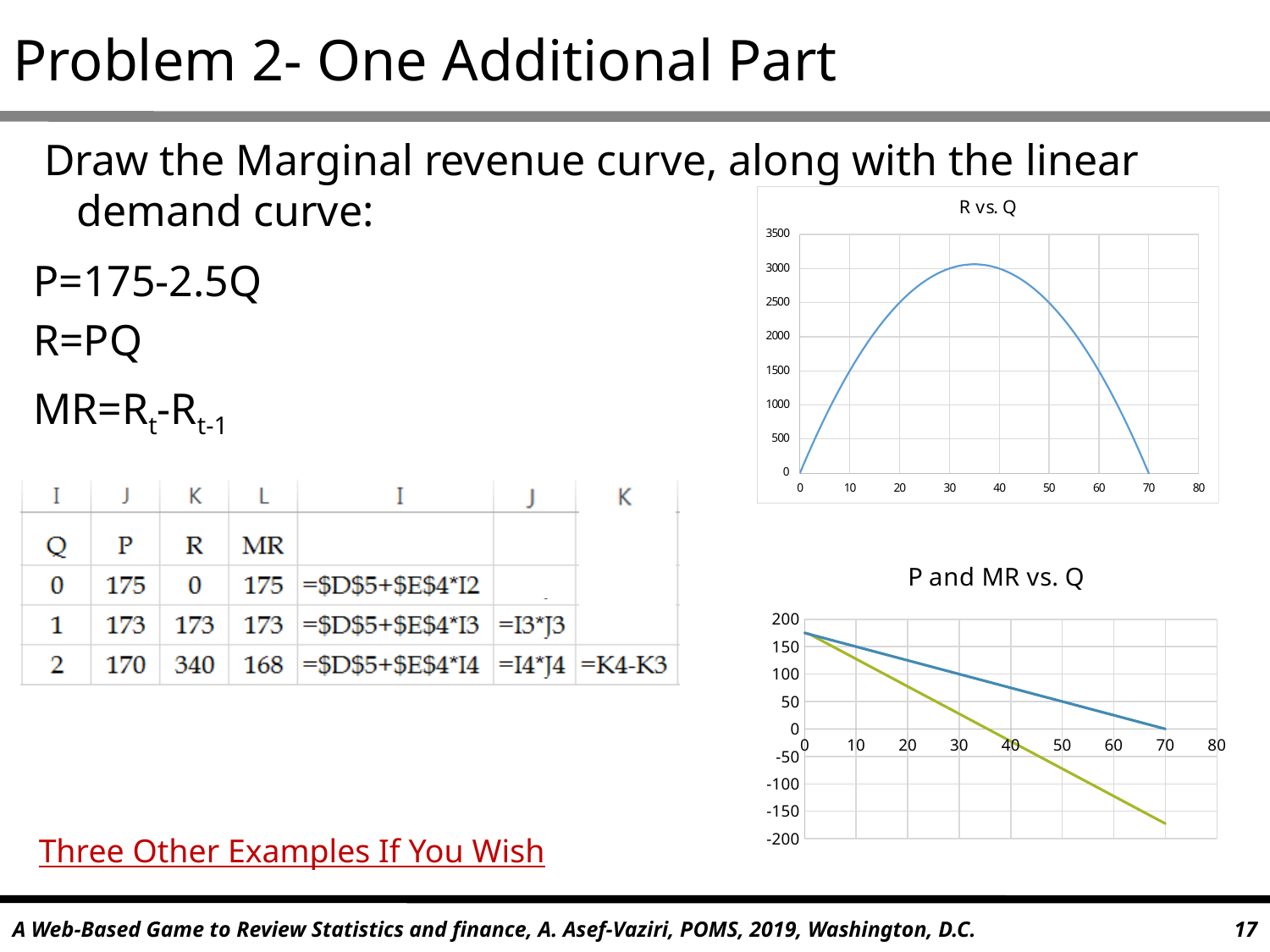
What kind of chart is the 'R vs. Q' chart? line chart In the 'P and MR vs. Q' chart, do the lines rise or fall as Q increases? fall In the 'R vs. Q' chart, does the curve rise or fall as Q goes from 40 to 70? fall In the 'R vs. Q' chart, is the peak value of the curve greater or less than 3500? less In the 'R vs. Q' chart, does the curve rise or fall as Q goes from 0 to 30? rise In the 'P and MR vs. Q' chart, is the value of the blue line at Q=40 greater or less than 50? greater In the 'P and MR vs. Q' chart, is the value of the green line at Q=70 greater or less than -150? less In the 'P and MR vs. Q' chart, at Q=40, which line is higher, the blue line or the green line? the blue line How many lines are plotted in the 'P and MR vs. Q' chart? 2 What kind of chart is the 'P and MR vs. Q' chart? line chart